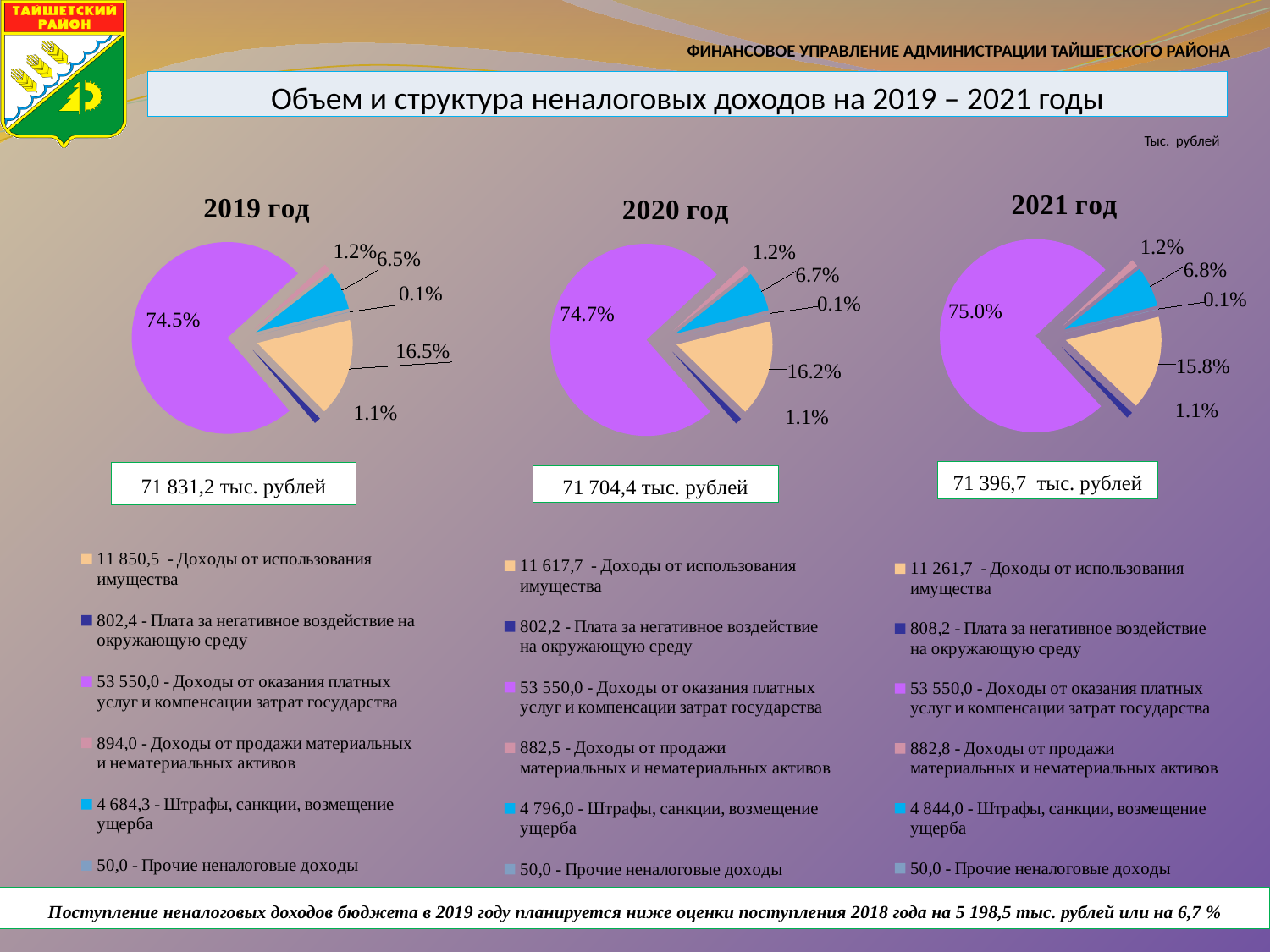
How many entries does the legend of the 2021 год chart list? 6 How many slices does the 2020 год pie chart have? 6 What kind of chart is used for the 2019 год chart? pie chart What total is shown below the 2021 год chart? 71 396,7 тыс. рублей According to the legend of the 2019 год chart, what is the value for Штрафы, санкции, возмещение ущерба? 4 684,3 In the 2021 год chart, which category has the largest share? Доходы от оказания платных услуг и компенсации затрат государства In the 2019 год chart, what share of the pie is labelled for the largest slice? 74.5% In the 2020 год chart, what share is shown for the slice labelled 16.2%'s neighbour, the Штрафы, санкции, возмещение ущерба slice? 6.7% In the 2021 год chart, what is the share of the Доходы от использования имущества slice? 15.8% In the 2019 год chart, what is the difference between the 74.5% slice and the 16.5% slice? 58.0% In the 2019 год chart, which category has the smallest share? Прочие неналоговые доходы In the 2020 год chart, which is larger: the Штрафы, санкции, возмещение ущерба slice or the Доходы от продажи материальных и нематериальных активов slice? Штрафы, санкции, возмещение ущерба